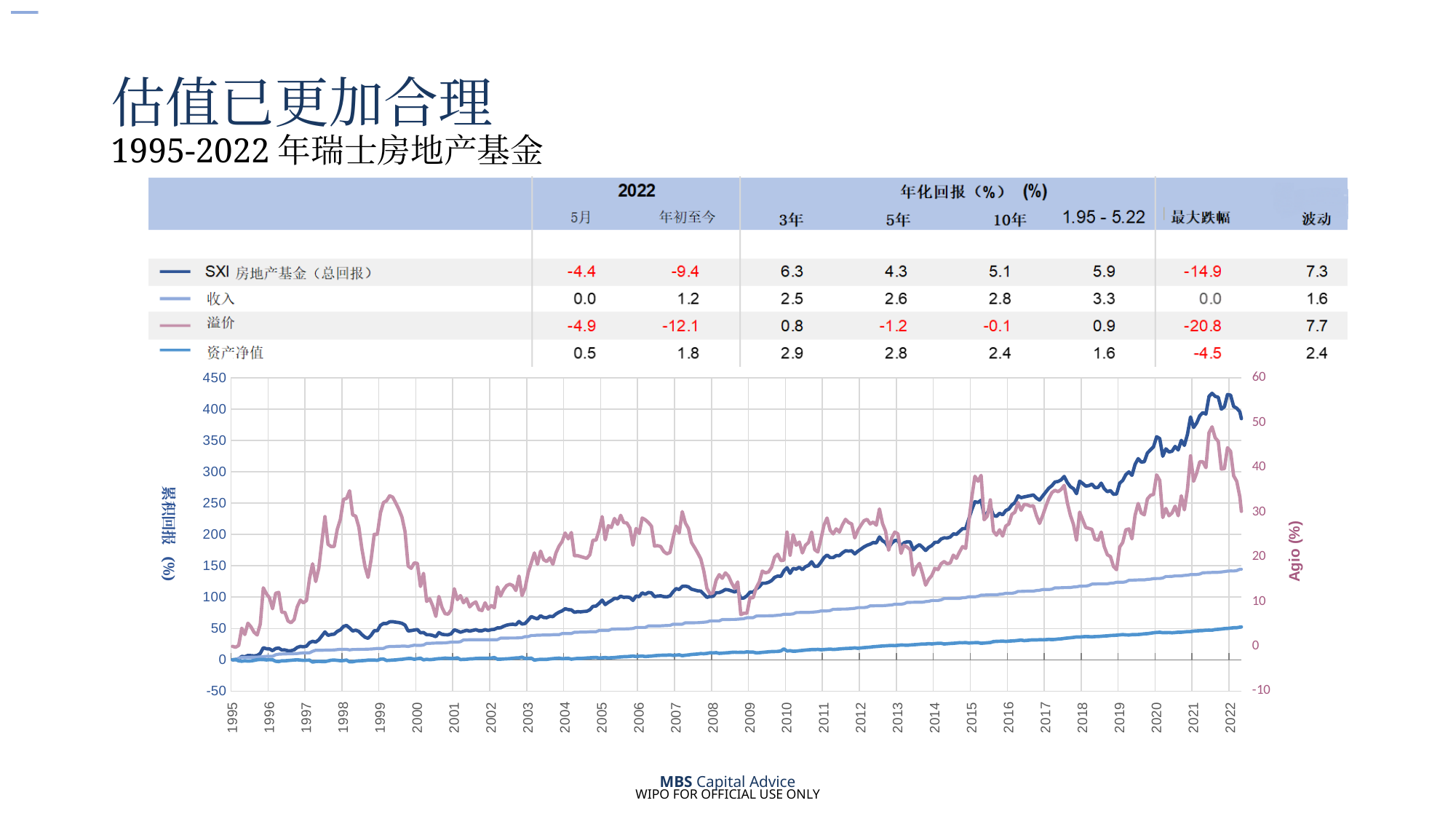
How many series (lines) are plotted in the chart? 4 How many year labels are shown on the x axis of the chart? 28 Is the cumulative return of the 资产净值 line at the end of 2022 greater or less than 100? less Is the cumulative return of SXI 房地产基金（总回报） at the end of 2022 greater or less than 350? greater What kind of chart is shown below the table on the slide? line chart Which series has the higher cumulative return at the end of 2022, SXI 房地产基金（总回报） or 收入? SXI 房地产基金（总回报） What is the label of the right vertical axis of the chart? Agio (%) Does the SXI 房地产基金（总回报） line rise or fall overall from 1995 to 2022? rises What is the label of the left vertical axis of the chart? 累积回报（%） Is the cumulative return of the 收入 line at the end of 2022 greater or less than 100? greater In the table above the chart, what is the 最大跌幅 value for SXI 房地产基金（总回报）? -14.9 In the table above the chart, what is the 年初至今 value for 溢价? -12.1